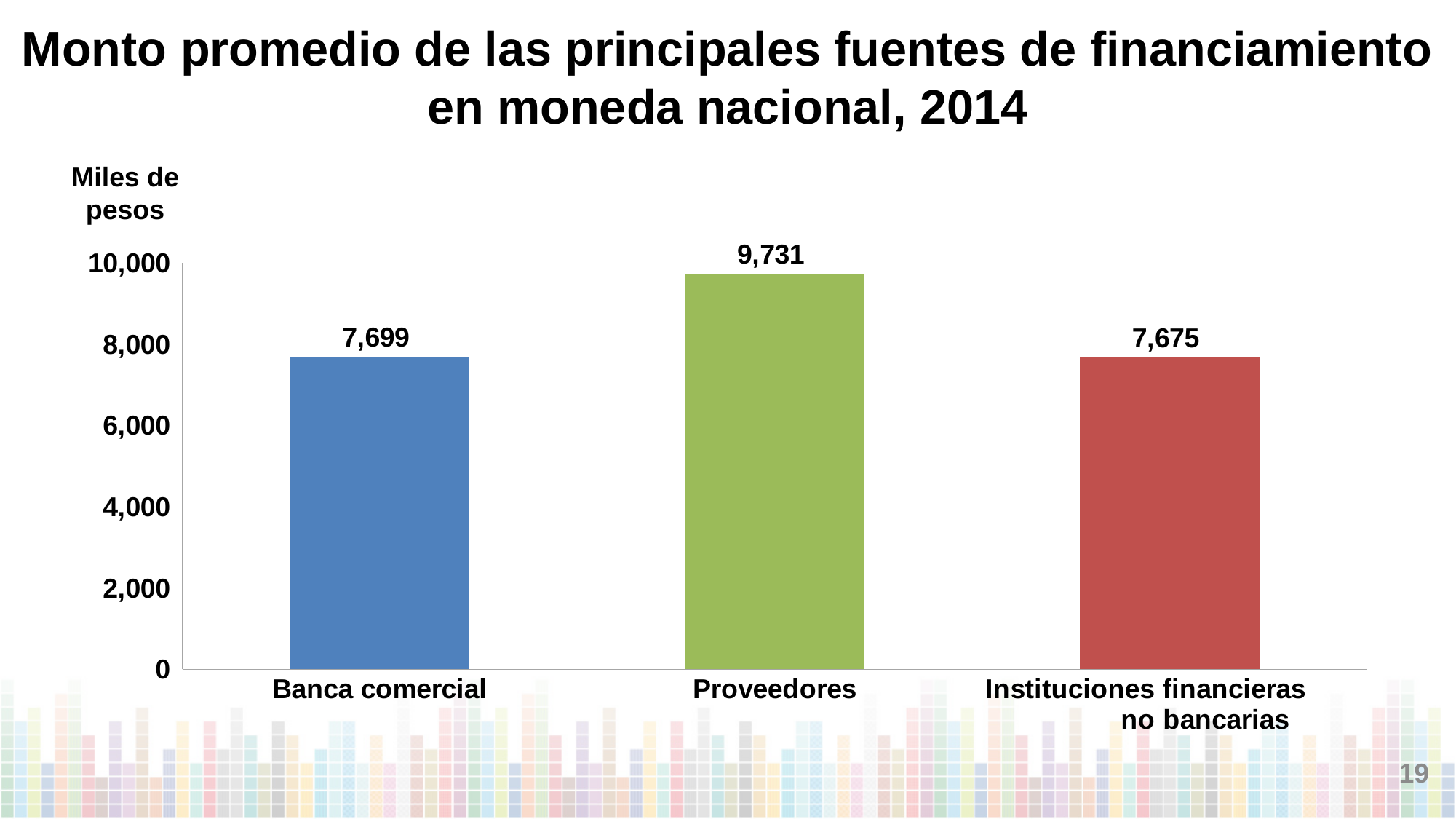
Which category has the highest value? Proveedores What is the difference between the values for Proveedores and Banca comercial? 2,032 What kind of chart is shown on the slide? Bar chart What is the value for Proveedores? 9,731 Which is larger, the value for Proveedores or the value for Instituciones financieras no bancarias? Proveedores How many categories are shown in the chart? 3 What is the value for Instituciones financieras no bancarias? 7,675 Is the value for Proveedores greater or less than 8,000? greater What is the value for Banca comercial? 7,699 Is the value for Banca comercial greater or less than 8,000? less What is the difference between the values for Banca comercial and Instituciones financieras no bancarias? 24 What unit is shown on the vertical axis of the chart? Miles de pesos